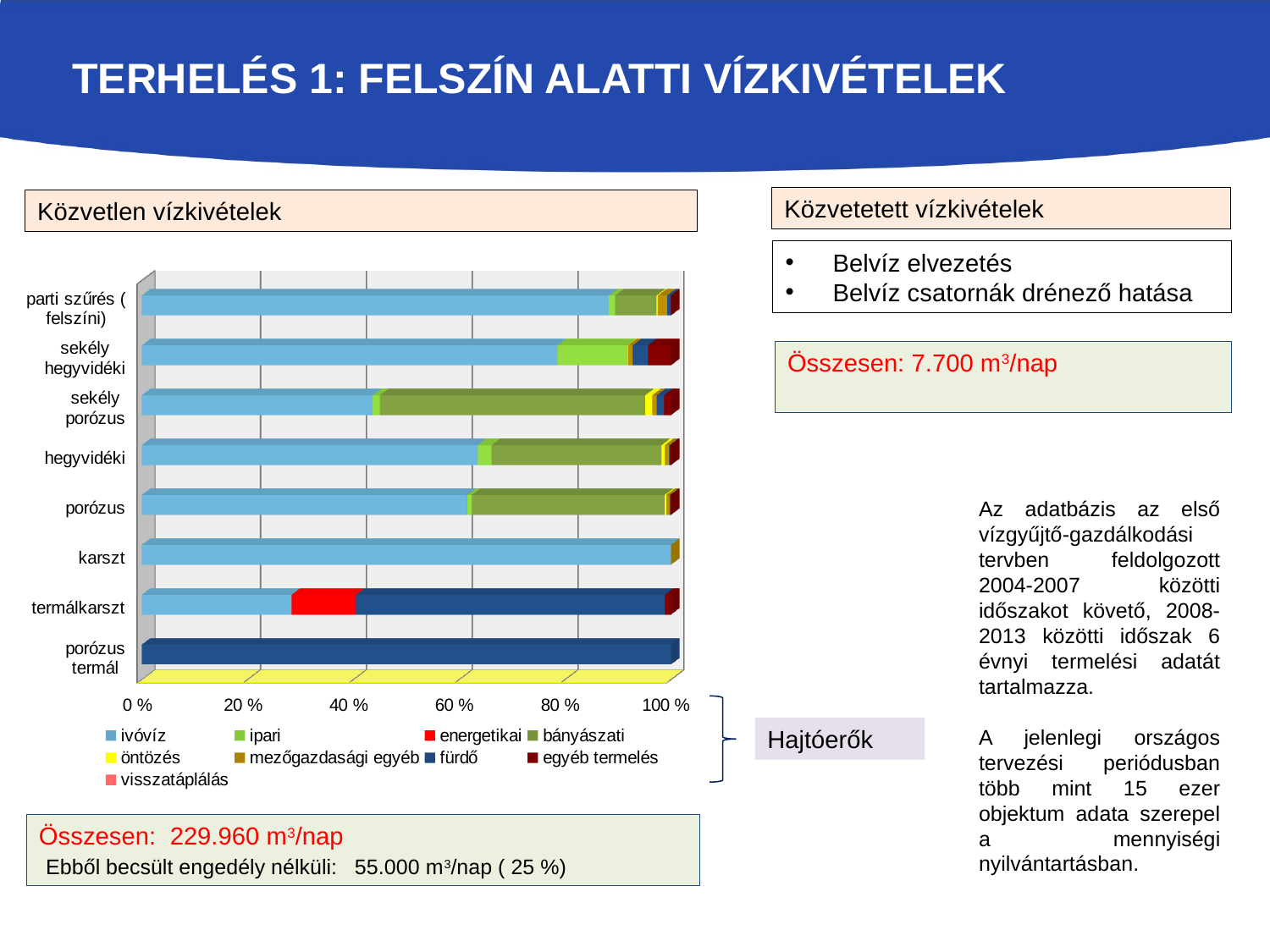
Which category has no ivóvíz share at all in the chart? porózus termál Is the fürdő share for porózus termál greater or less than 80 %? greater What kind of chart is shown under "Közvetlen vízkivételek"? stacked bar chart Which series is shown in red in the chart legend? energetikai What is the highest value shown on the horizontal axis of the chart? 100 % How many categories (aquifer types) are listed on the vertical axis of the chart? 8 Which category has the largest ivóvíz share in the chart? karszt Which has the larger ivóvíz share: karszt or termálkarszt? karszt Is the ivóvíz share for karszt greater or less than 80 %? greater Is the ivóvíz share for sekély porózus greater or less than 60 %? less How many series does the chart legend list? 9